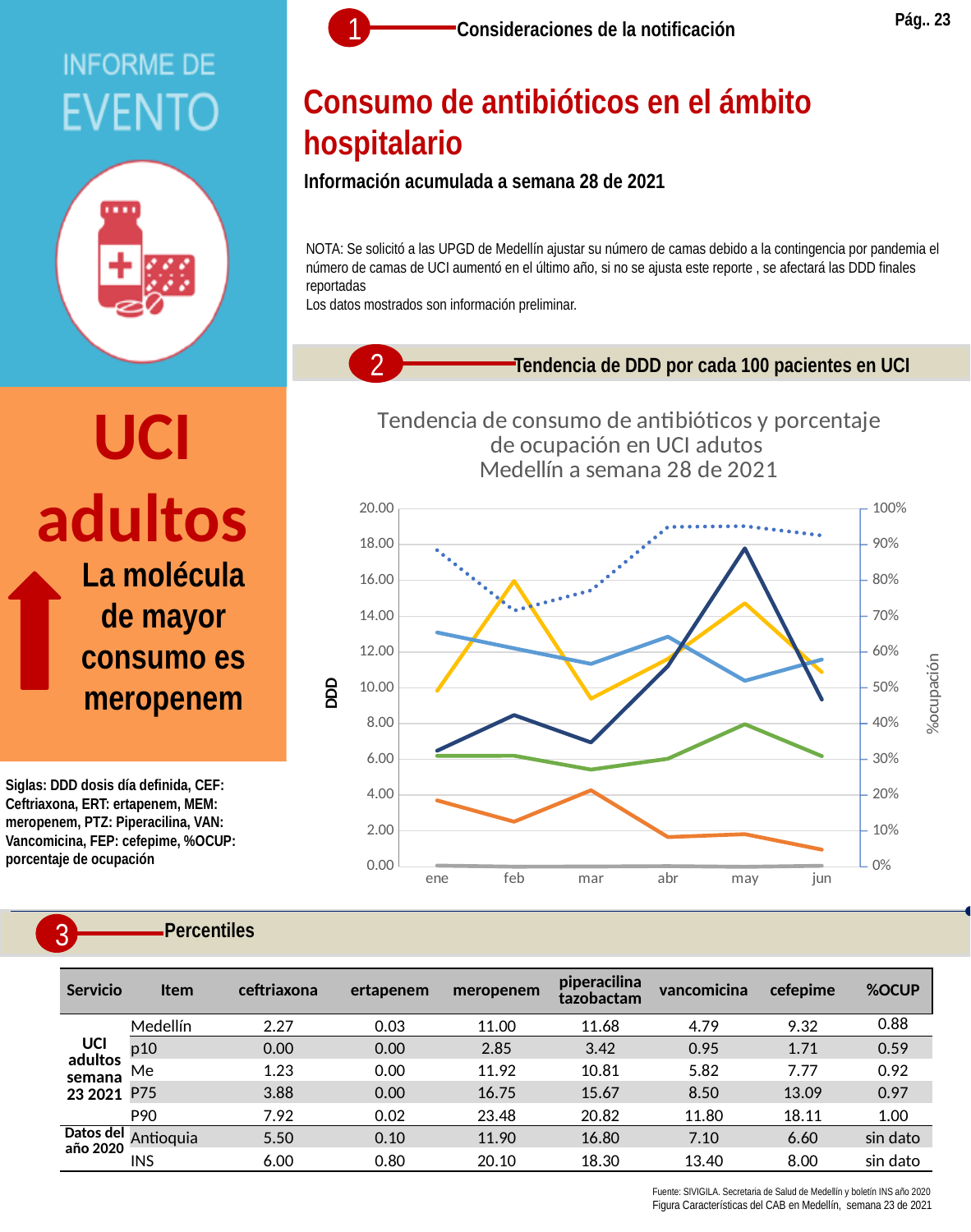
Does the orange line rise or fall overall from ene to jun? fall Is the value of the dark blue line in may greater or less than 16.00? greater How many months are shown along the x axis of the chart? 6 Is the value of the orange line in mar greater or less than 6.00? less Does the green line rise or fall from abr to may? rise In may, which is higher: the dark blue line or the yellow line? the dark blue line What is the title of the chart? Tendencia de consumo de antibióticos y porcentaje de ocupación en UCI adutos Medellín a semana 28 de 2021 What kind of chart is shown on the slide? line chart In which month does the orange line reach its lowest value? jun In which month does the dark blue line reach its highest value? may Is the value of the dotted line in may greater or less than 90%? greater What is the label of the left vertical axis of the chart? DDD